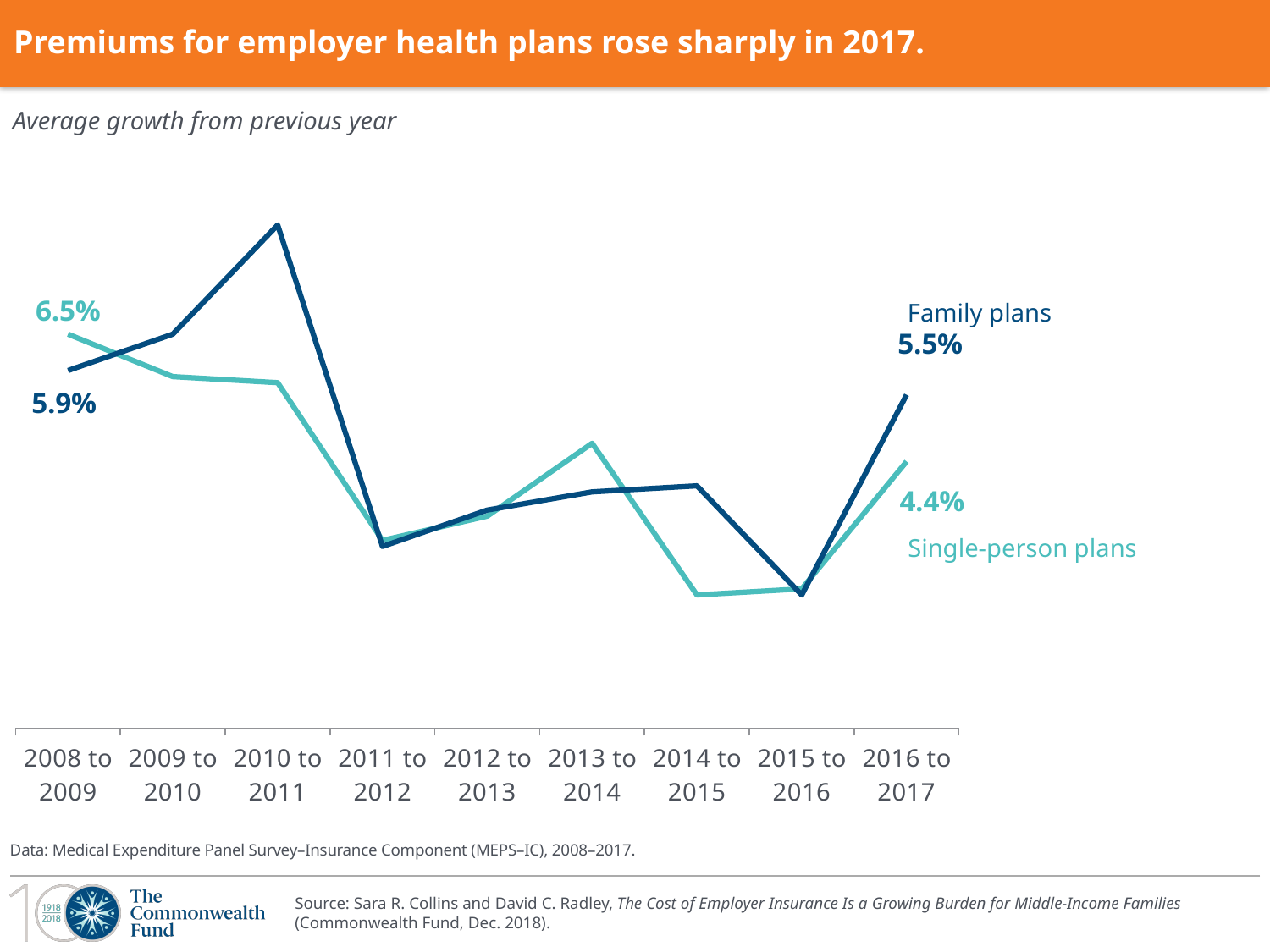
How many series are plotted on the chart? 2 What type of chart is shown on the slide? Line chart What is the difference between single-person plan growth and family plan growth for 2008 to 2009? 0.6 percentage points What was the average growth for family plans from 2016 to 2017? 5.5% What is the difference between family plan growth and single-person plan growth for 2016 to 2017? 1.1 percentage points How many year-to-year periods are shown on the x axis? 9 What was the average growth for single-person plans from 2016 to 2017? 4.4% What was the average growth for single-person plans from 2008 to 2009? 6.5% In which period did family plan premium growth reach its highest point? 2010 to 2011 For 2016 to 2017, which series shows higher growth: family plans or single-person plans? Family plans For 2008 to 2009, which series shows higher growth: family plans or single-person plans? Single-person plans What was the average growth for family plans from 2008 to 2009? 5.9%